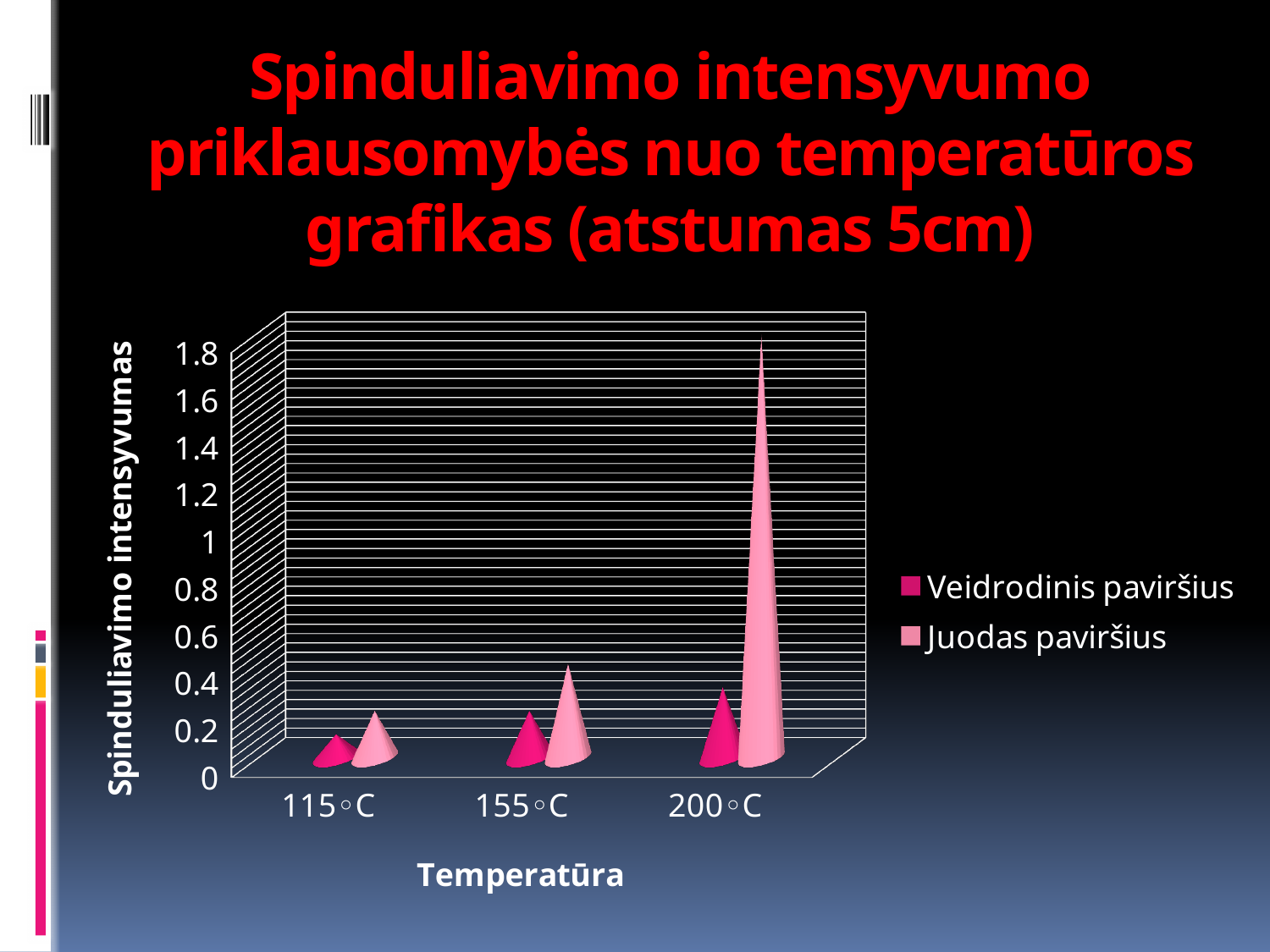
For the Juodas paviršius series, at which temperature is the radiation intensity highest? 200°C What is the title of the vertical axis? Spinduliavimo intensyvumas Do the values for Juodas paviršius rise or fall as temperature increases along the x axis? rise How many temperature categories are shown on the x axis? 3 Is the value for Veidrodinis paviršius at 200°C greater or less than 0.6? less For the Veidrodinis paviršius series, at which temperature is the radiation intensity highest? 200°C How many series does the legend list? 2 For the Juodas paviršius series, at which temperature is the radiation intensity lowest? 115°C What kind of chart is shown on the slide? bar chart What are the two series named in the legend? Veidrodinis paviršius and Juodas paviršius Is the value for Juodas paviršius at 200°C greater or less than 1? greater At 200°C, which series has the larger value: Veidrodinis paviršius or Juodas paviršius? Juodas paviršius